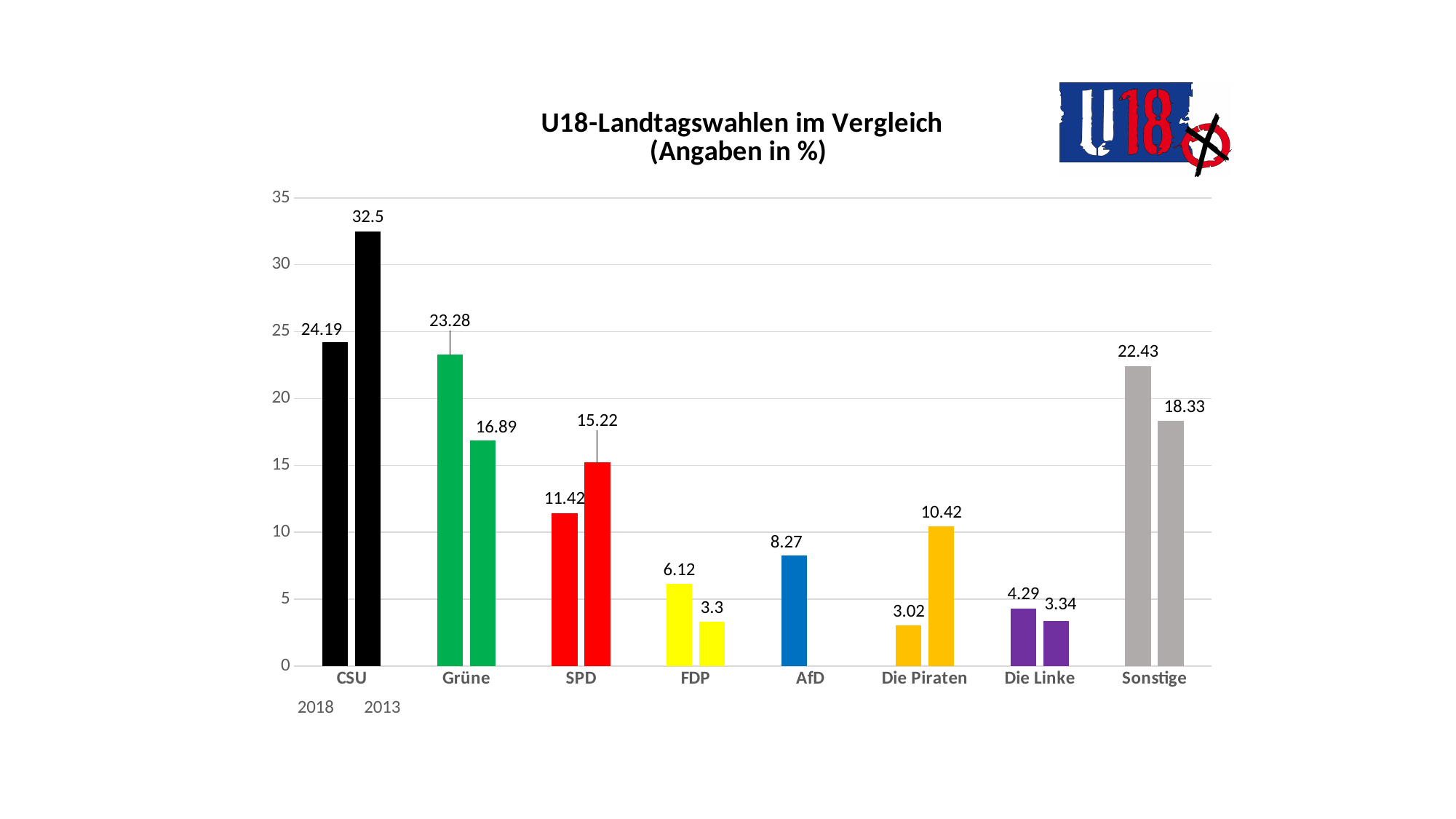
Which is larger for SPD, the 2018 value or the 2013 value? 2013 Which bar has the lowest value in the chart? Die Piraten 2018 (3.02) What is the 2013 value for Die Piraten? 10.42 What is the 2013 value for CSU? 32.5 What is the title of the chart? U18-Landtagswahlen im Vergleich (Angaben in %) What type of chart is shown on the slide? bar chart What is the difference between the CSU 2013 value and the CSU 2018 value? 8.31 What is the value shown for AfD? 8.27 Which party has the highest value in the chart? CSU What is the difference between the Sonstige 2018 value and the Sonstige 2013 value? 4.1 What is the 2018 value for Grüne? 23.28 How many parties (categories) are shown on the x axis? 8